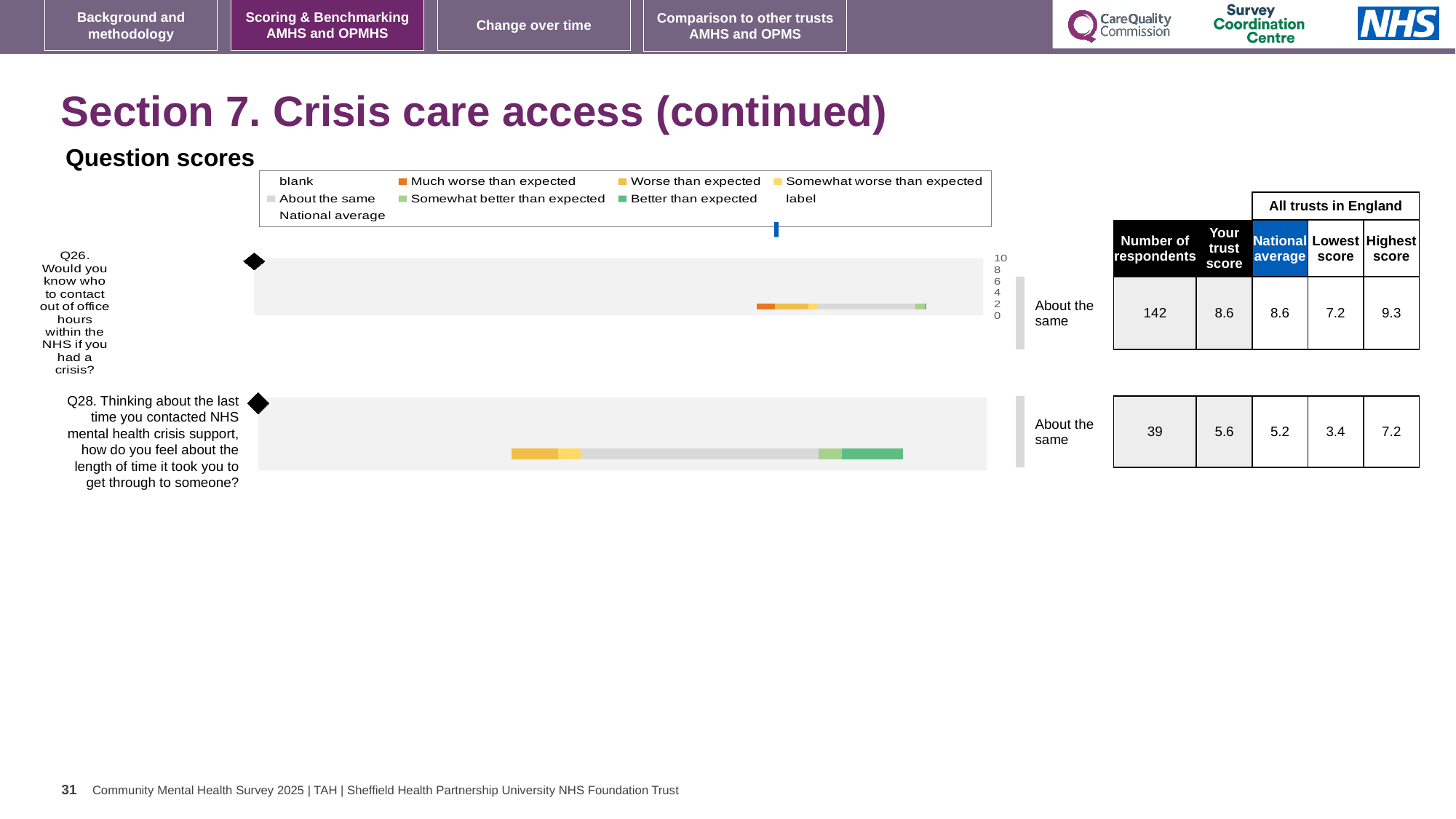
Which question has the higher trust score, Q26 or Q28? Q26 What is the national average score for Q28? 5.2 What kind of chart is used to show the question scores on this slide? bar chart How many questions are plotted as bars on the slide? 2 What colour does the legend use for 'Much worse than expected'? orange What is the trust score for Q26 (knowing who to contact out of office hours)? 8.6 What is the difference between the highest score and the lowest score for Q26? 2.1 By how much does the trust score for Q28 exceed the national average for Q28? 0.4 What is the trust score for Q28 (length of time to get through to crisis support)? 5.6 What benchmark category label is shown next to the bar for Q26? About the same How many respondents answered Q28? 39